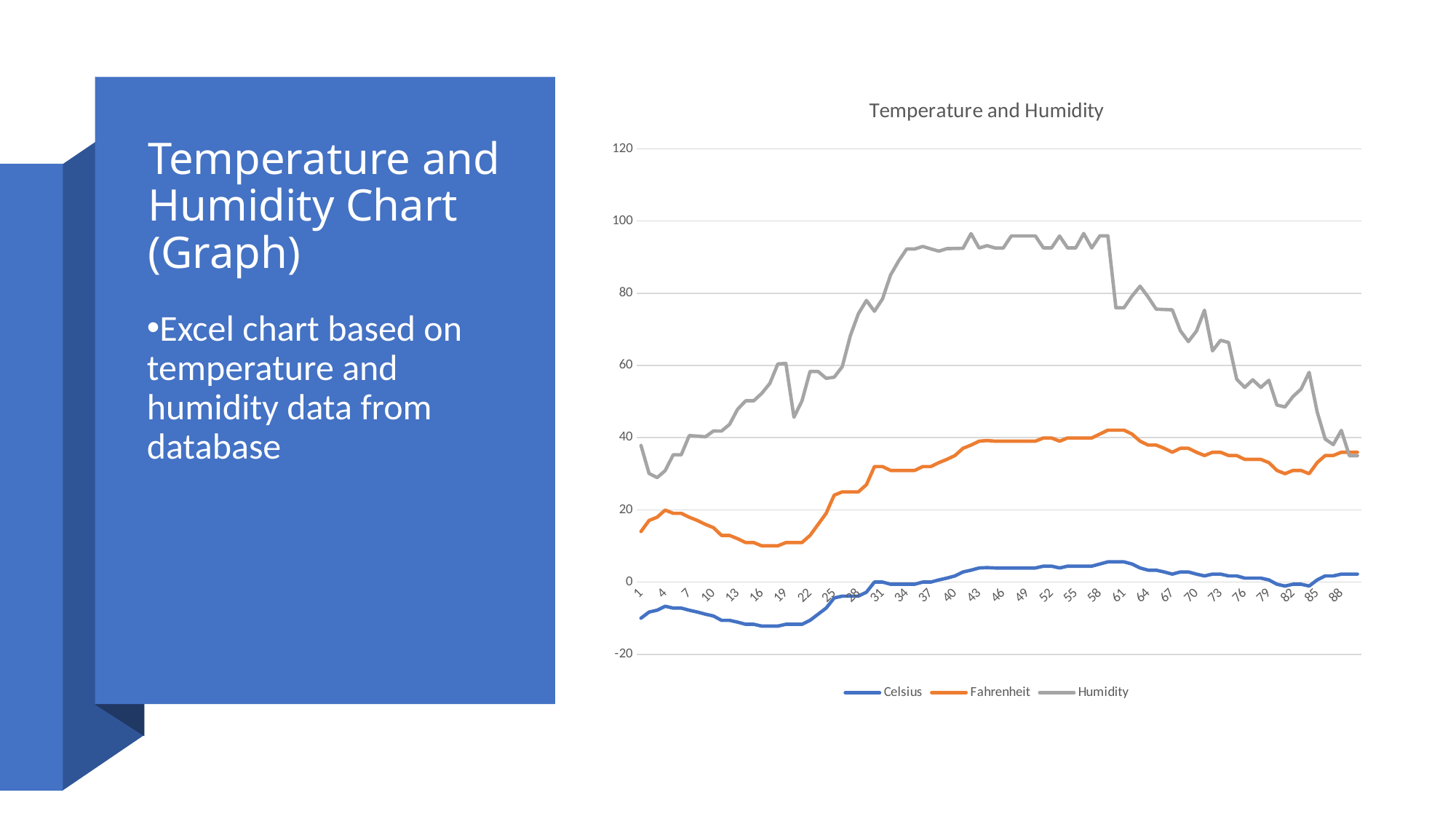
What is the title of the chart? Temperature and Humidity At x = 43, which is larger, the Humidity value or the Fahrenheit value? Humidity Which series reaches the highest value on the chart? Humidity Is the Fahrenheit value at x = 16 greater or less than 20? less Which series has the lowest values on the chart? Celsius Is the Celsius value at x = 1 greater or less than 0? less How many series does the legend list? 3 Which series is drawn in orange? Fahrenheit Does the Humidity series rise or fall between x = 61 and x = 88? fall What kind of chart is shown on the slide? line chart Is the Humidity value at x = 4 greater or less than 40? less